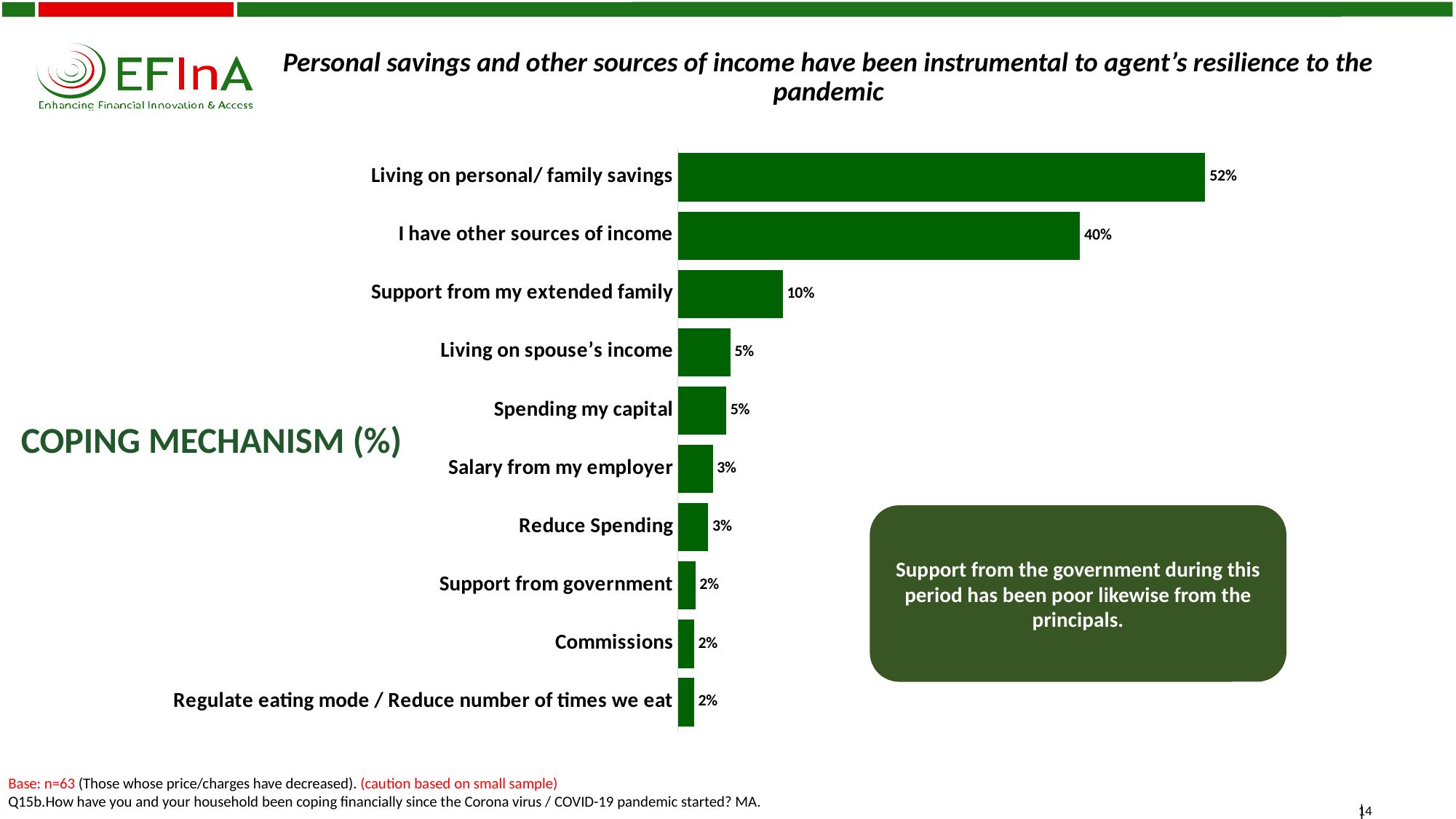
What is the difference in percentage points between 'Support from my extended family' and 'Spending my capital'? 5 What type of chart is used on this slide? Bar chart What is the sample size (base) stated for the chart? n=63 How many coping mechanisms are listed in the chart? 10 What percentage is shown for 'Support from my extended family'? 10% What is the value shown for 'I have other sources of income'? 40% What is the difference in percentage points between 'Living on personal/ family savings' and 'I have other sources of income'? 12 What value is shown for 'Support from government'? 2% Which coping mechanism has the highest percentage? Living on personal/ family savings Which is larger: 'Support from my extended family' or 'Salary from my employer'? Support from my extended family What is the title of the chart on the left side of the slide? COPING MECHANISM (%) What percentage of agents reported living on personal/family savings as a coping mechanism? 52%